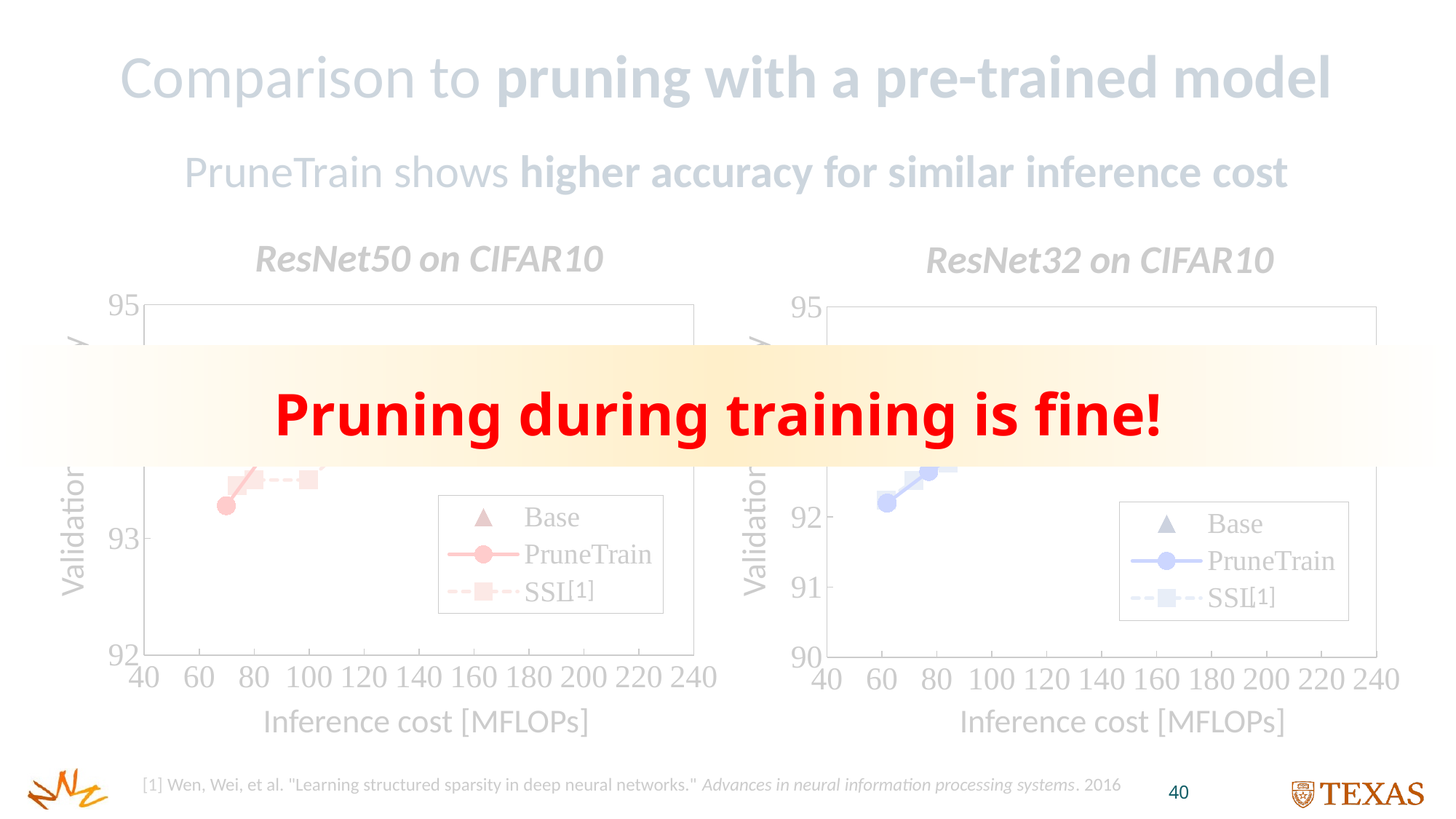
What kind of chart is the ResNet50 on CIFAR10 chart? line chart On the ResNet32 on CIFAR10 chart, how many series does the legend list? 3 On the ResNet50 on CIFAR10 chart, is the inference cost of the rightmost SSL[1] point greater or less than 120 MFLOPs? less On the ResNet50 on CIFAR10 chart, is the inference cost of the lowest-cost PruneTrain point greater or less than 80 MFLOPs? less On the ResNet32 on CIFAR10 chart, is the validation accuracy of the lowest-cost PruneTrain point greater or less than 92? greater What is the x-axis label of the ResNet32 on CIFAR10 chart? Inference cost [MFLOPs] On the ResNet50 on CIFAR10 chart, what are the three series named in the legend? Base, PruneTrain, SSL[1] On the ResNet50 on CIFAR10 chart, how many series does the legend list? 3 On the ResNet50 on CIFAR10 chart, which has the higher inference cost: the rightmost SSL[1] point or the lowest-cost PruneTrain point? the rightmost SSL[1] point